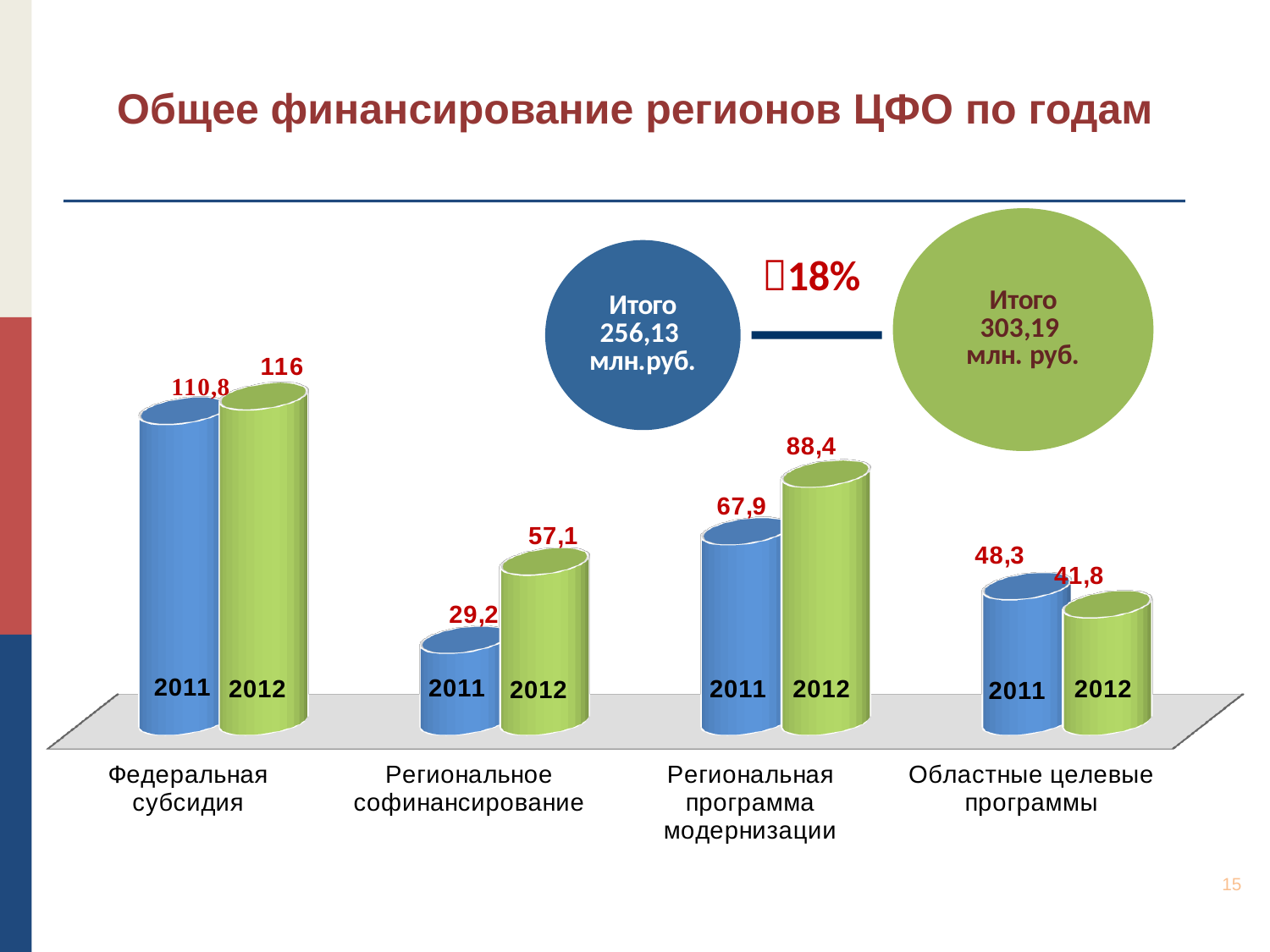
What is the total (Итого) for 2012 shown in the green circle? 303,19 млн. руб. What kind of chart is shown on the slide? Bar chart Which category has the lowest 2011 value? Региональное софинансирование What is the 2011 value for Федеральная субсидия? 110,8 For Областные целевые программы, which year has the larger value, 2011 or 2012? 2011 What is the 2012 value for Региональная программа модернизации? 88,4 How many categories are shown on the x axis? 4 What is the 2012 value for Региональное софинансирование? 57,1 Which category has the highest 2012 value? Федеральная субсидия What is the 2011 value for Областные целевые программы? 48,3 What is the difference between the 2012 and 2011 values for Региональное софинансирование? 27,9 How many years (series) are plotted for each category? 2